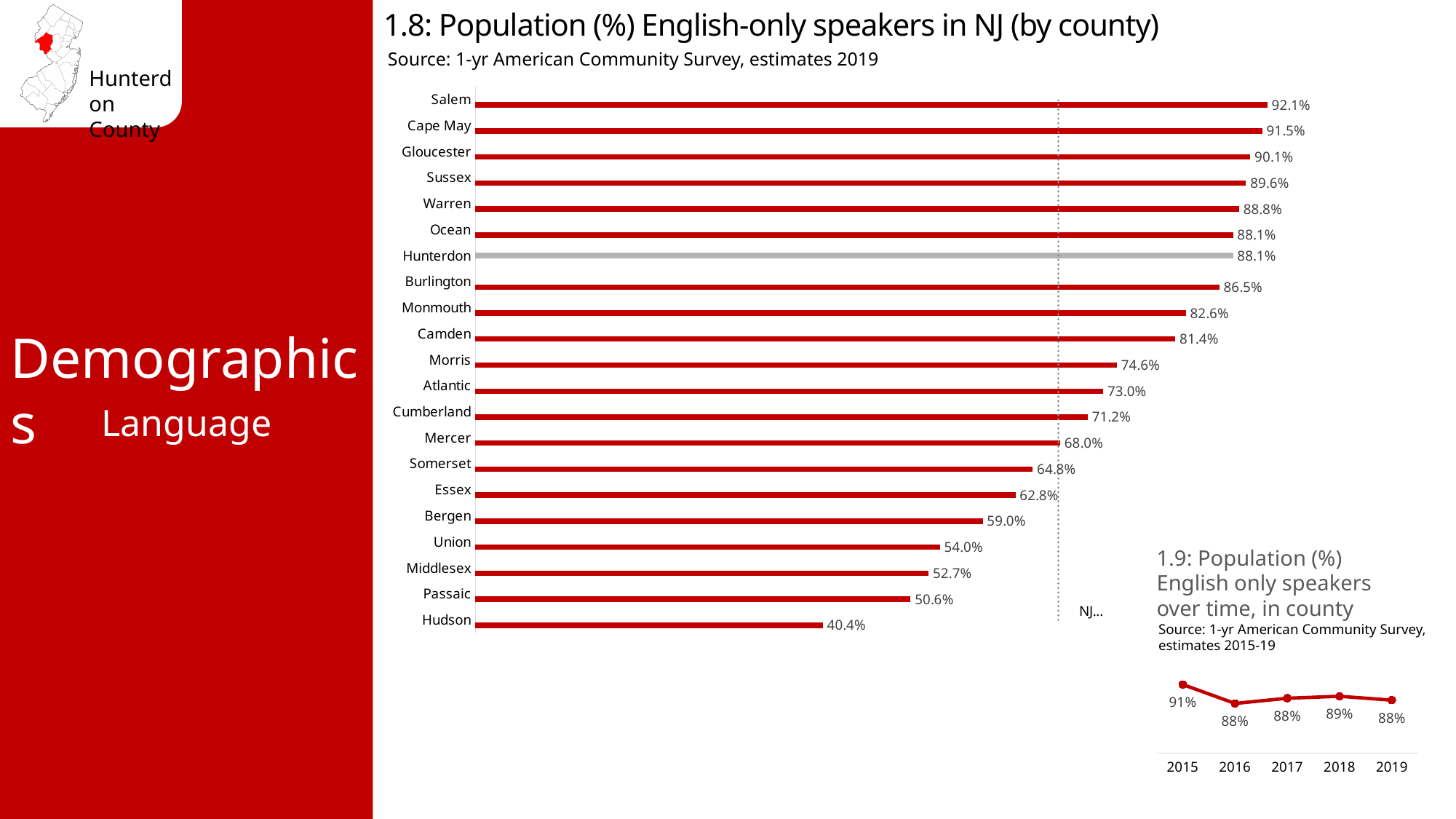
What kind of chart is chart 1.9 (Population (%) English only speakers over time, in county)? Line chart In chart 1.9 (Population (%) English only speakers over time, in county), what is the value for 2018? 89% What kind of chart is chart 1.8 (Population (%) English-only speakers in NJ by county)? Bar chart In chart 1.8 (Population (%) English-only speakers in NJ by county), which county has the highest value? Salem In chart 1.8 (Population (%) English-only speakers in NJ by county), which is larger, Bergen or Union? Bergen In chart 1.8 (Population (%) English-only speakers in NJ by county), what is the value for Morris? 74.6% In chart 1.8 (Population (%) English-only speakers in NJ by county), how many counties are shown? 21 In chart 1.9 (Population (%) English only speakers over time, in county), how many years are plotted? 5 In chart 1.9 (Population (%) English only speakers over time, in county), what is the value for 2015? 91% In chart 1.8 (Population (%) English-only speakers in NJ by county), which county has the lowest value? Hudson In chart 1.8 (Population (%) English-only speakers in NJ by county), what is the difference between Salem and Hudson? 51.7% In chart 1.8 (Population (%) English-only speakers in NJ by county), what is the value for Hunterdon? 88.1%